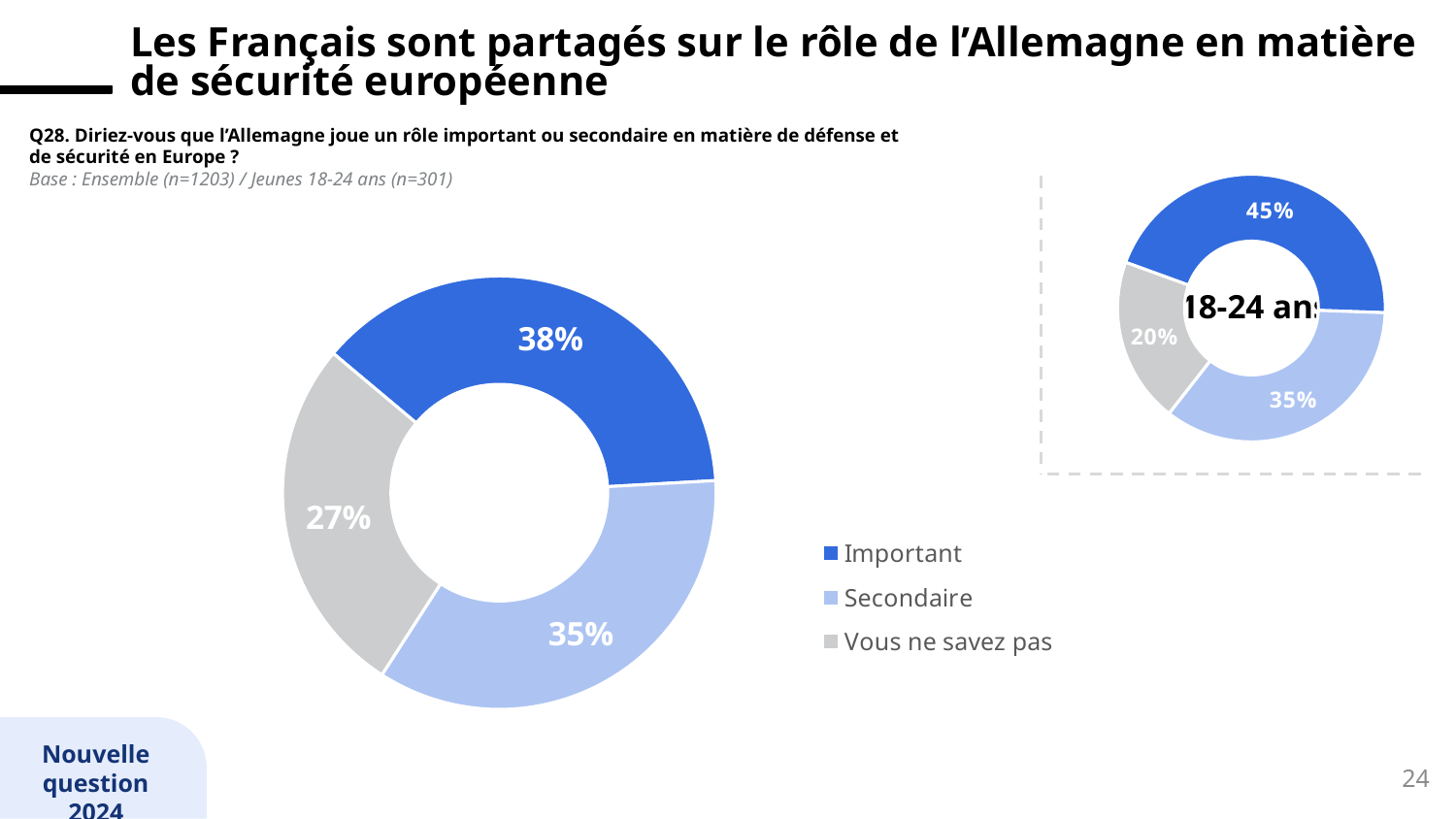
In the small "18-24 ans" donut chart on the right, what percentage is shown for "Important"? 45% How many categories does the legend list? 3 In the large donut chart on the left, which category has the largest share? Important In the large donut chart on the left, what percentage is shown for "Vous ne savez pas"? 27% Which colour represents "Secondaire" in the legend? Light blue In the small "18-24 ans" donut chart on the right, what percentage is shown for "Vous ne savez pas"? 20% In the small "18-24 ans" donut chart on the right, what is the combined share of "Important" and "Secondaire"? 80% What kind of chart is the large chart on the left? Donut (pie) chart In the large donut chart on the left, what percentage is shown for "Important"? 38% Is the "Important" share larger in the large chart on the left or in the small "18-24 ans" chart on the right? The small "18-24 ans" chart on the right In the large donut chart on the left, what is the difference between the "Important" and "Vous ne savez pas" shares? 11 percentage points In the small "18-24 ans" donut chart on the right, which category has the smallest share? Vous ne savez pas